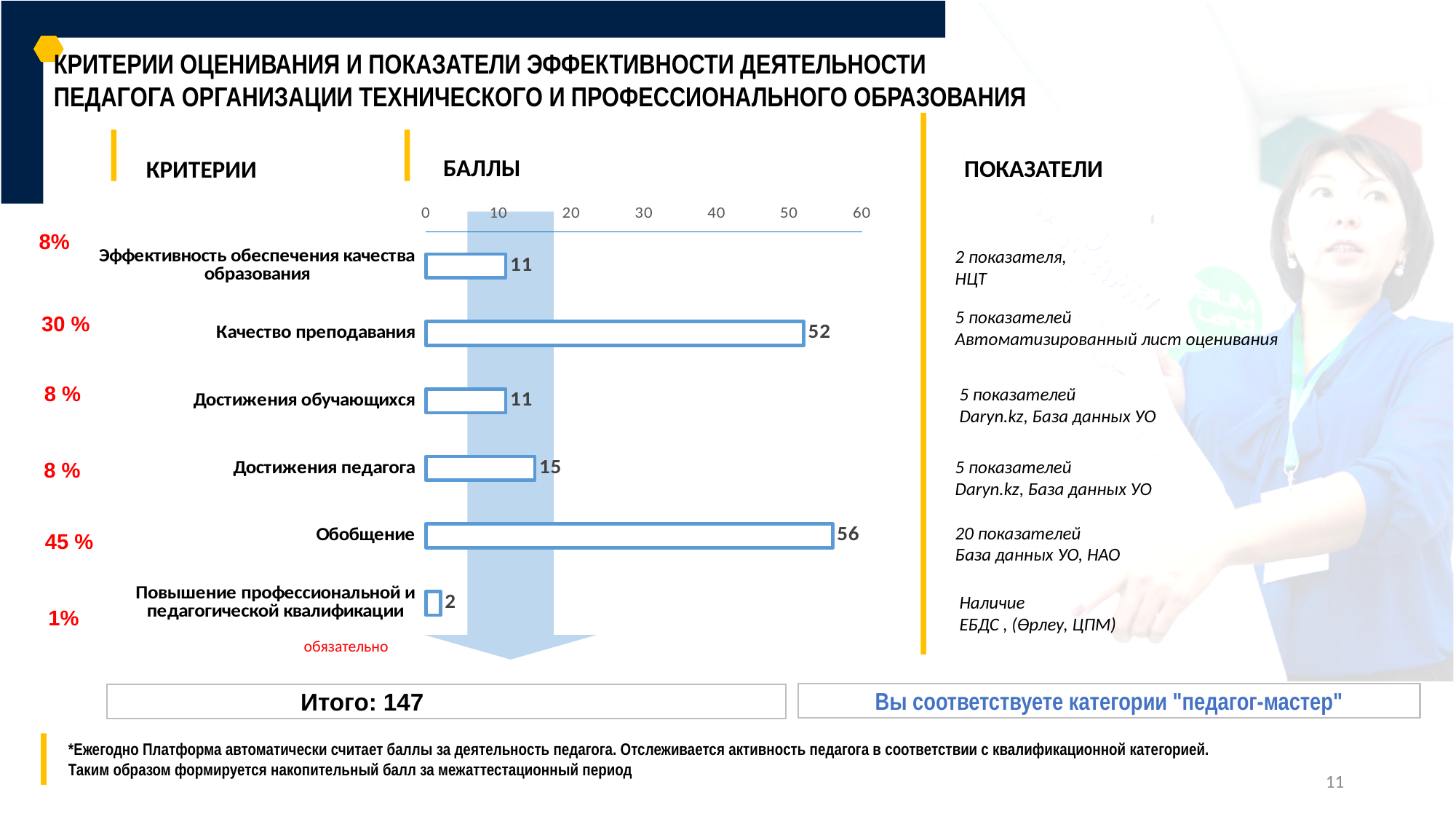
What value is shown for "Качество преподавания"? 52 Which category has the lowest value? Повышение профессиональной и педагогической квалификации What value is shown for "Обобщение"? 56 What value is shown for "Достижения педагога"? 15 What is the highest tick value shown on the chart's axis? 60 Which category has the highest value? Обобщение How many categories does the chart show? 6 What is the difference between the values for "Обобщение" and "Качество преподавания"? 4 Which is larger, the value for "Достижения педагога" or the value for "Достижения обучающихся"? Достижения педагога What kind of chart is shown on the slide? bar chart Is the value for "Качество преподавания" greater or less than 50? greater What value is shown for "Повышение профессиональной и педагогической квалификации"? 2